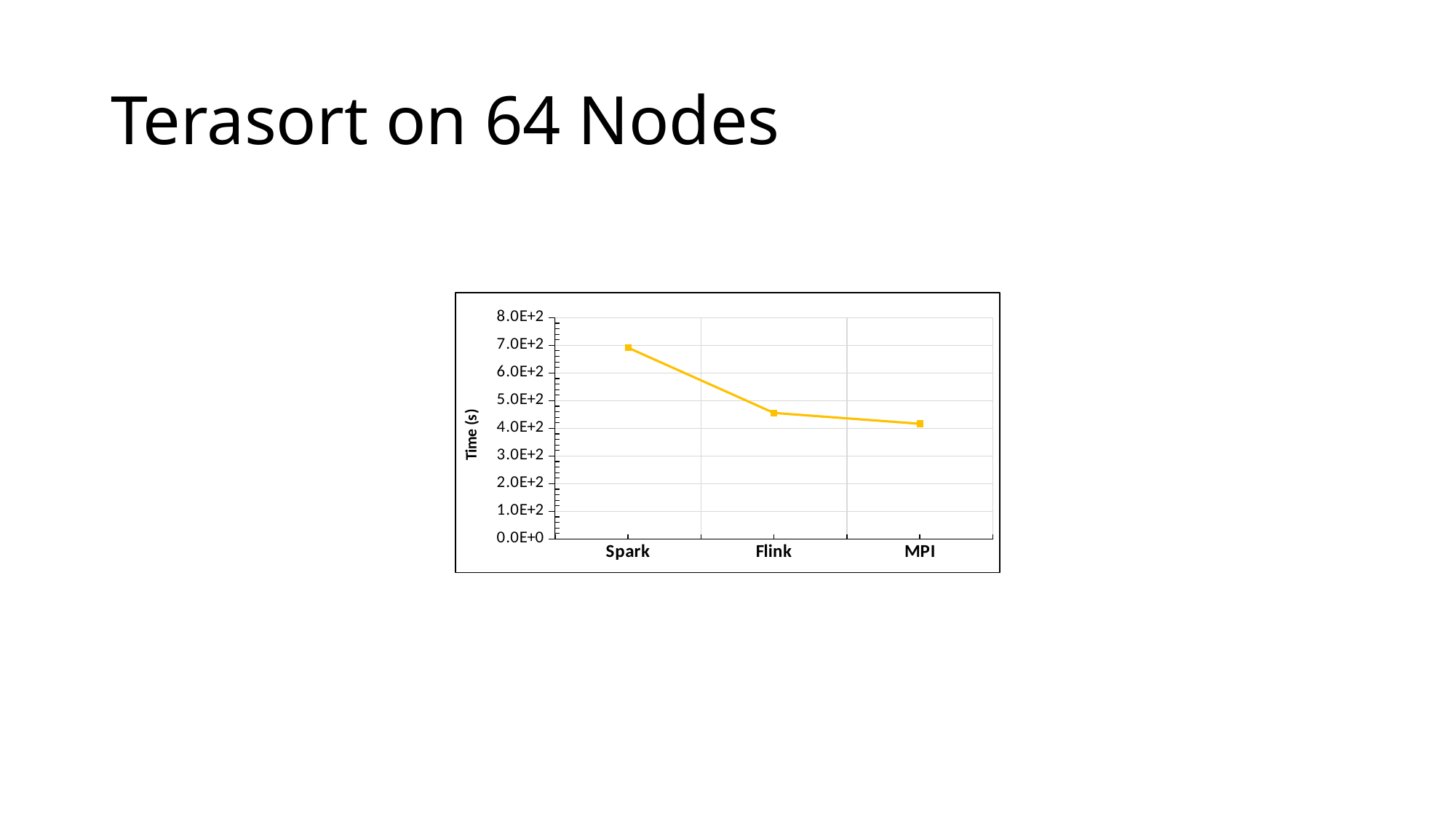
Which category has the highest time? Spark Is the value for Flink greater or less than 5.0E+2? less Do the values rise or fall from Spark to MPI along the x axis? fall Which has the larger time, Spark or Flink? Spark What is the label of the y axis? Time (s) How many categories are plotted on the x axis? 3 Is the value for MPI greater or less than 5.0E+2? less What kind of chart is shown on the slide? line chart Which has the larger time, Flink or MPI? Flink Is the value for Flink greater or less than 3.0E+2? greater Which category has the lowest time? MPI